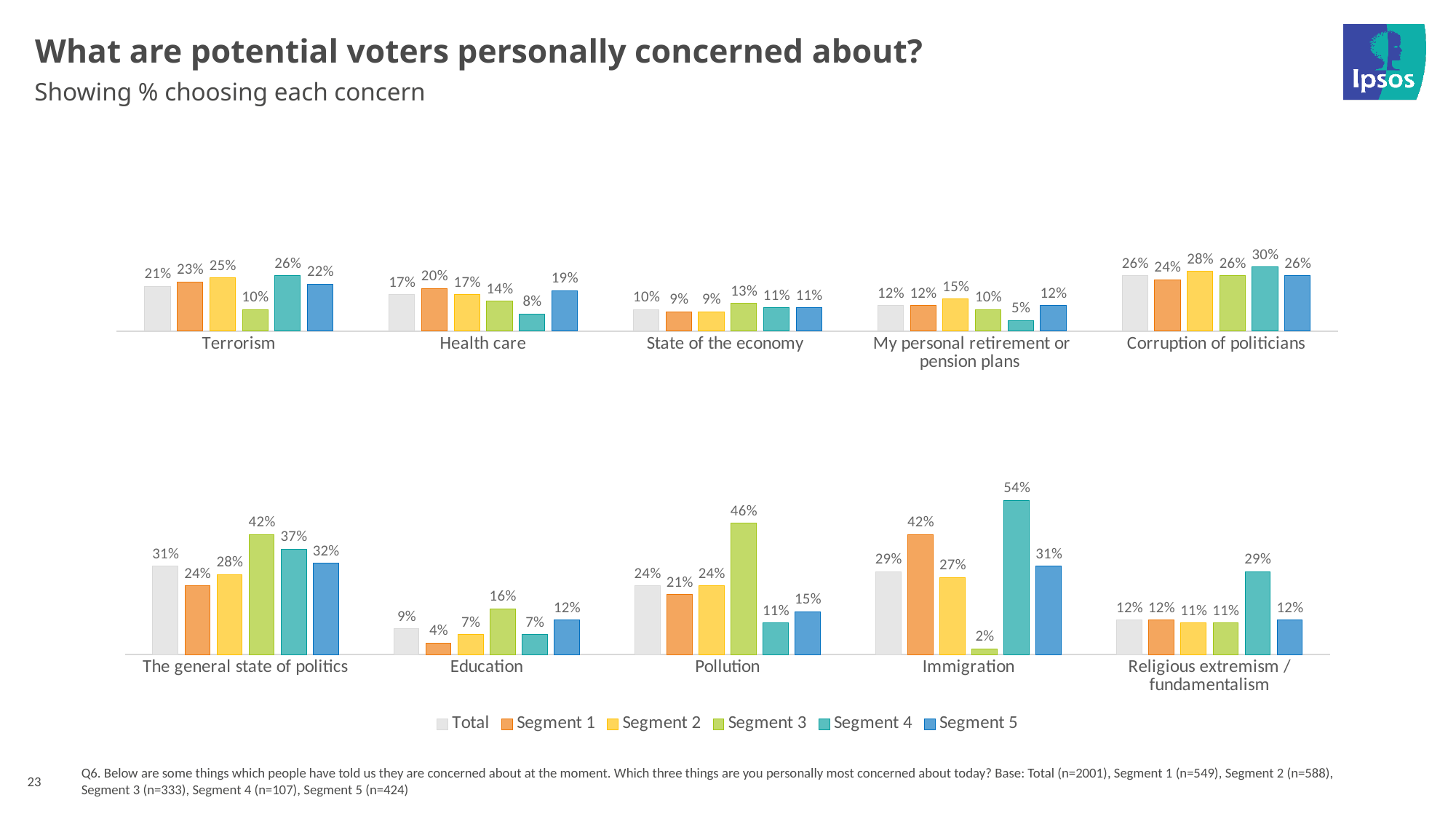
In the top chart, which is larger for Terrorism: Segment 2 or Segment 3? Segment 2 In the bottom chart, what is the value for Segment 4 for Immigration? 54% In the top chart, what is the difference between Segment 5 and Segment 4 for Health care? 11% How many concern categories are shown in the bottom chart? 5 In the bottom chart, which segment has the highest value for The general state of politics? Segment 3 How many series does the legend list? 6 In the top chart, what is the Total value for Corruption of politicians? 26% In the bottom chart, what is the value for Segment 3 for Pollution? 46% In the bottom chart, which is larger for Education: Segment 3 or Segment 5? Segment 3 In the bottom chart, what is the difference between Segment 4 and Segment 3 for Immigration? 52% What kind of chart is used on this slide? Bar chart In the top chart, which segment has the lowest value for My personal retirement or pension plans? Segment 4